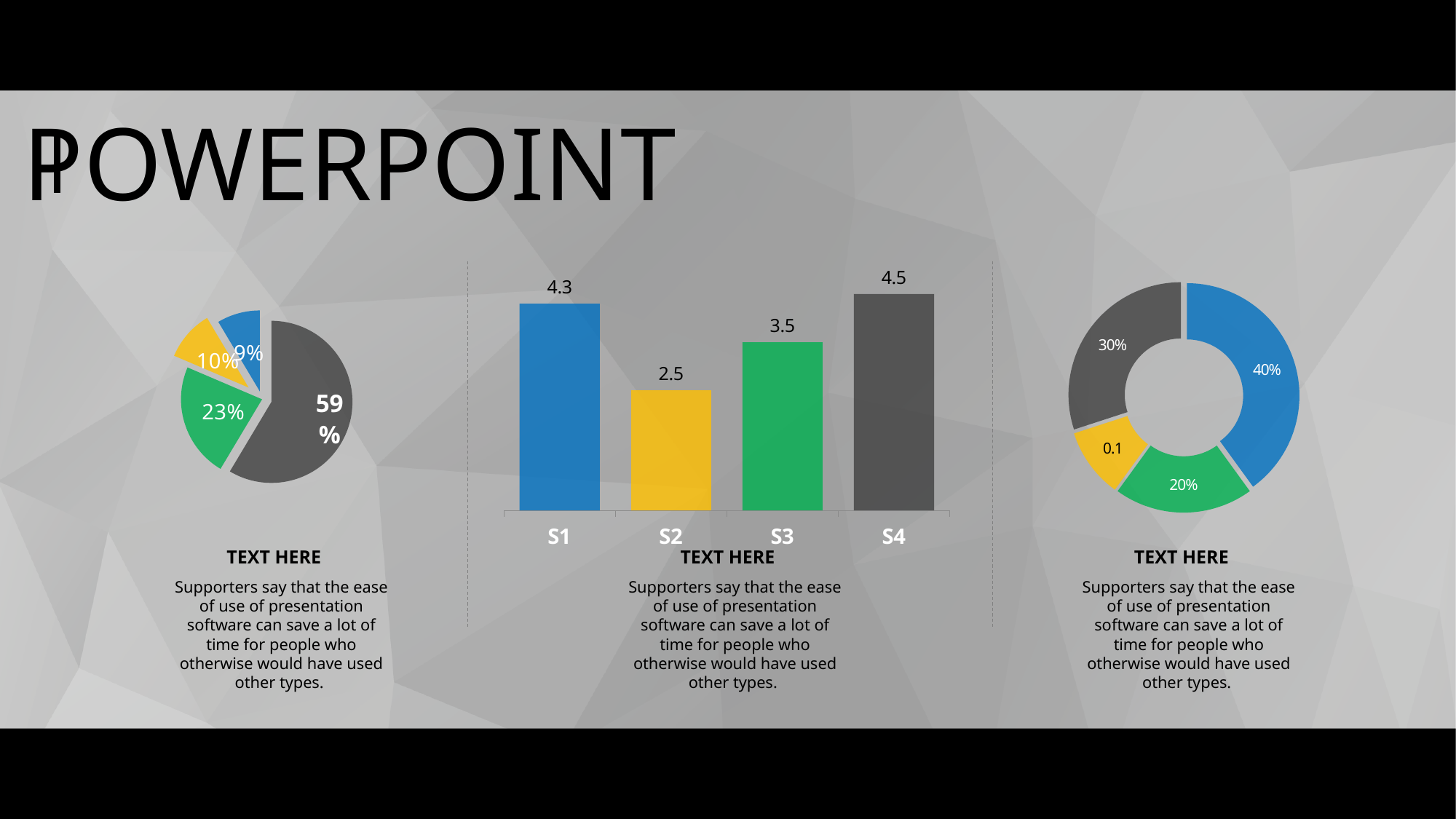
In the bar chart in the middle of the slide, what is the value for S1? 4.3 What kind of chart is shown in the middle of the slide? bar chart In the bar chart in the middle of the slide, which category has the highest value? S4 In the bar chart in the middle of the slide, which is larger, the value for S1 or the value for S3? S1 In the bar chart in the middle of the slide, what is the difference between the values for S4 and S3? 1.0 How many segments are in the doughnut chart on the right of the slide? 4 In the pie chart on the left of the slide, what is the smallest slice's share? 9% In the doughnut chart on the right of the slide, what share does the blue segment show? 40% How many bars are in the bar chart in the middle of the slide? 4 In the pie chart on the left of the slide, what is the largest slice's share? 59% In the bar chart in the middle of the slide, which category has the lowest value? S2 In the bar chart in the middle of the slide, what is the value for S2? 2.5